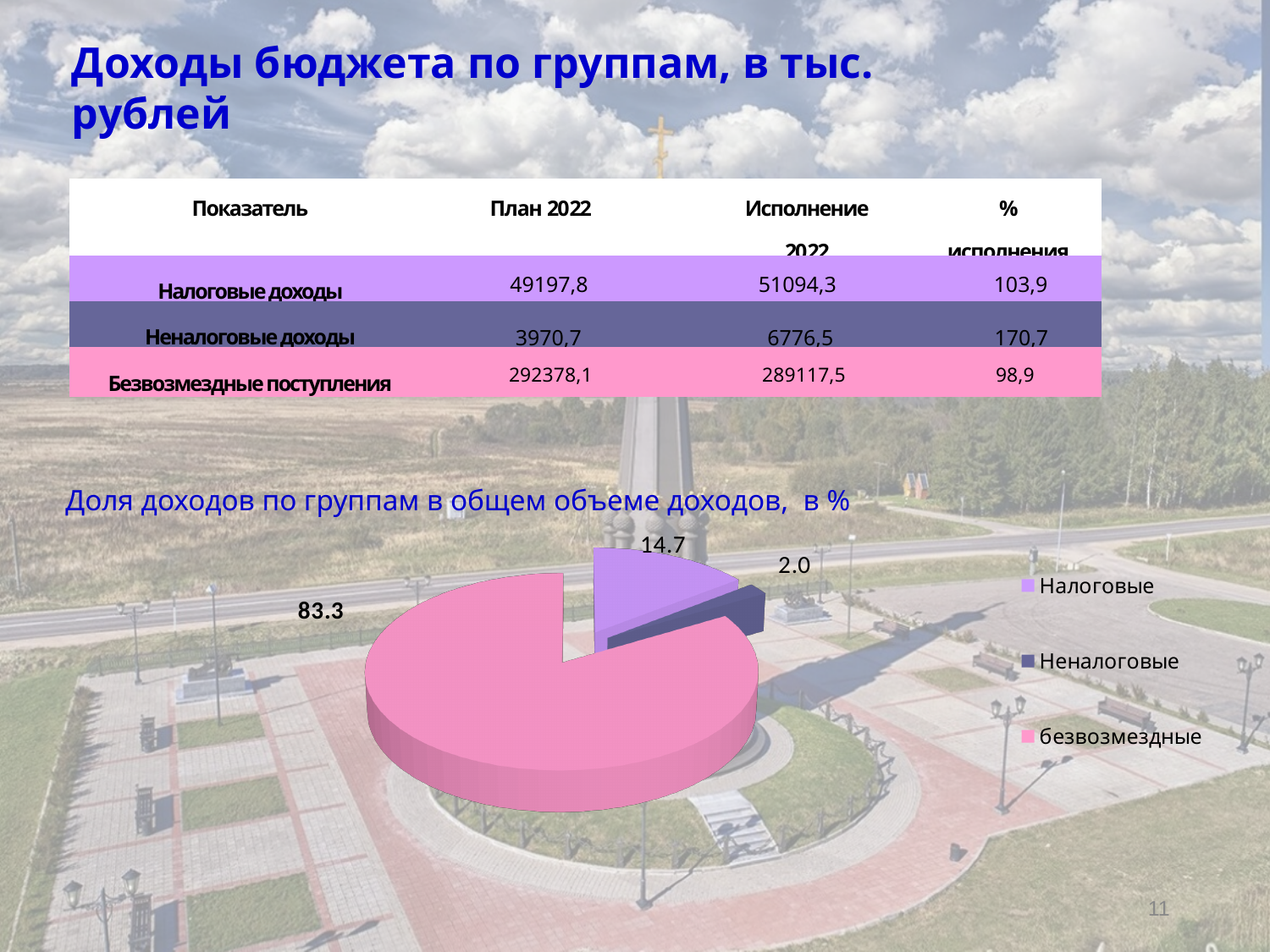
Which category has the largest slice in the pie chart? безвозмездные In the pie chart, what is the value shown for безвозмездные? 83.3 What colour is the безвозмездные slice in the pie chart? pink In the pie chart, which is larger: Налоговые or Неналоговые? Налоговые In the pie chart, what is the difference between the values for безвозмездные and Налоговые? 68.6 In the pie chart, what is the value shown for Неналоговые? 2.0 What kind of chart is shown on the slide? pie chart In the pie chart, what is the value shown for Налоговые? 14.7 In the pie chart, what is the difference between the values for Налоговые and Неналоговые? 12.7 Which category has the smallest slice in the pie chart? Неналоговые What is the title of the pie chart? Доля доходов по группам в общем объеме доходов, в % How many slices does the pie chart have? 3